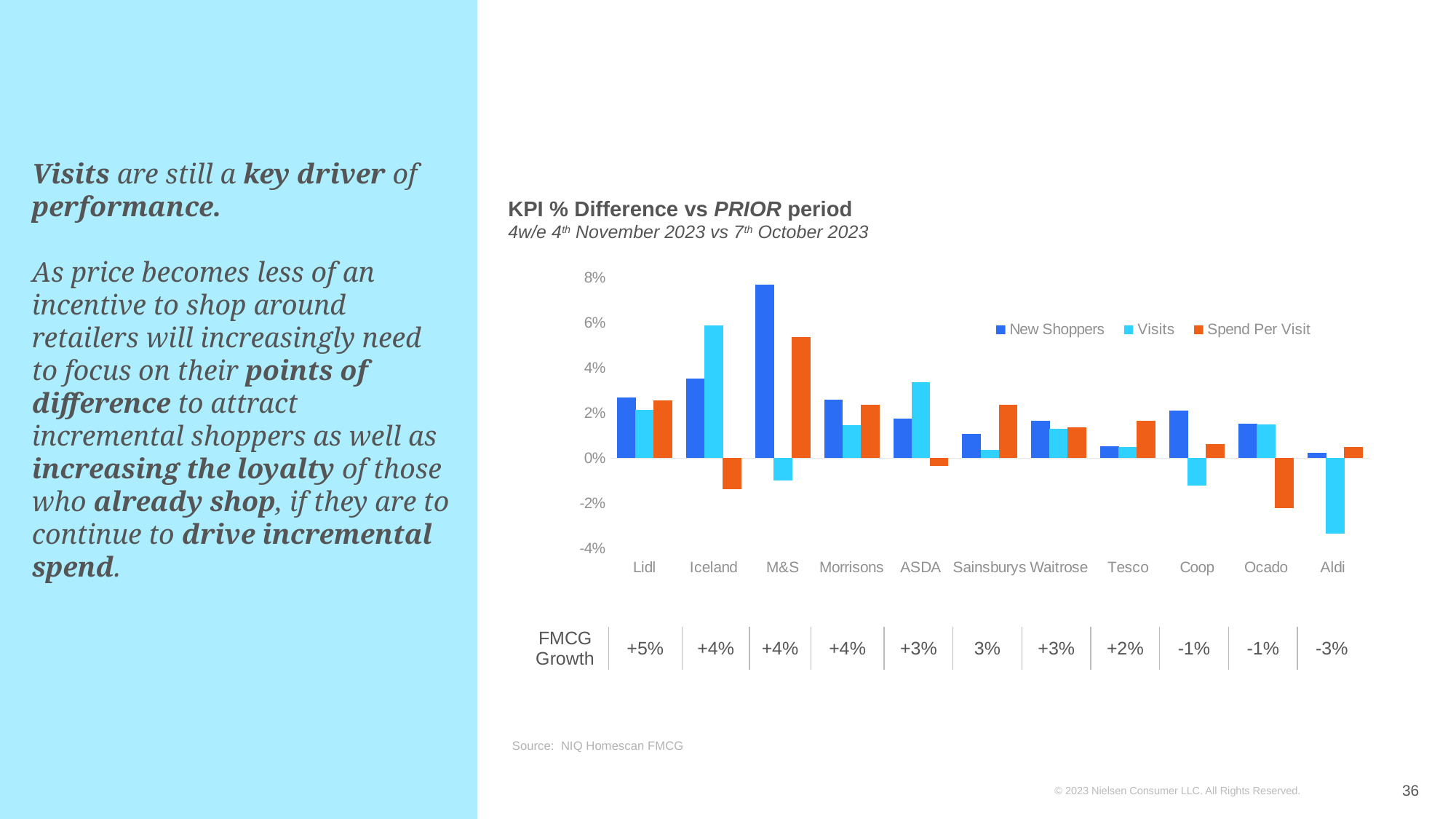
What is the FMCG Growth figure shown for Aldi? -3% Is the Visits value for Aldi greater or less than -2%? less Is the Spend Per Visit value for Ocado greater or less than 0%? less For Iceland, which is larger: the Visits value or the New Shoppers value? Visits Which retailer has the highest New Shoppers value? M&S Which retailer has the lowest Visits value? Aldi Is the New Shoppers value for M&S greater or less than 6%? greater How many series does the chart legend list? 3 Which retailer has the highest Visits value? Iceland What type of chart is shown on the slide? bar chart How many retailers are shown on the x axis of the chart? 11 What is the FMCG Growth figure shown for Lidl? +5%